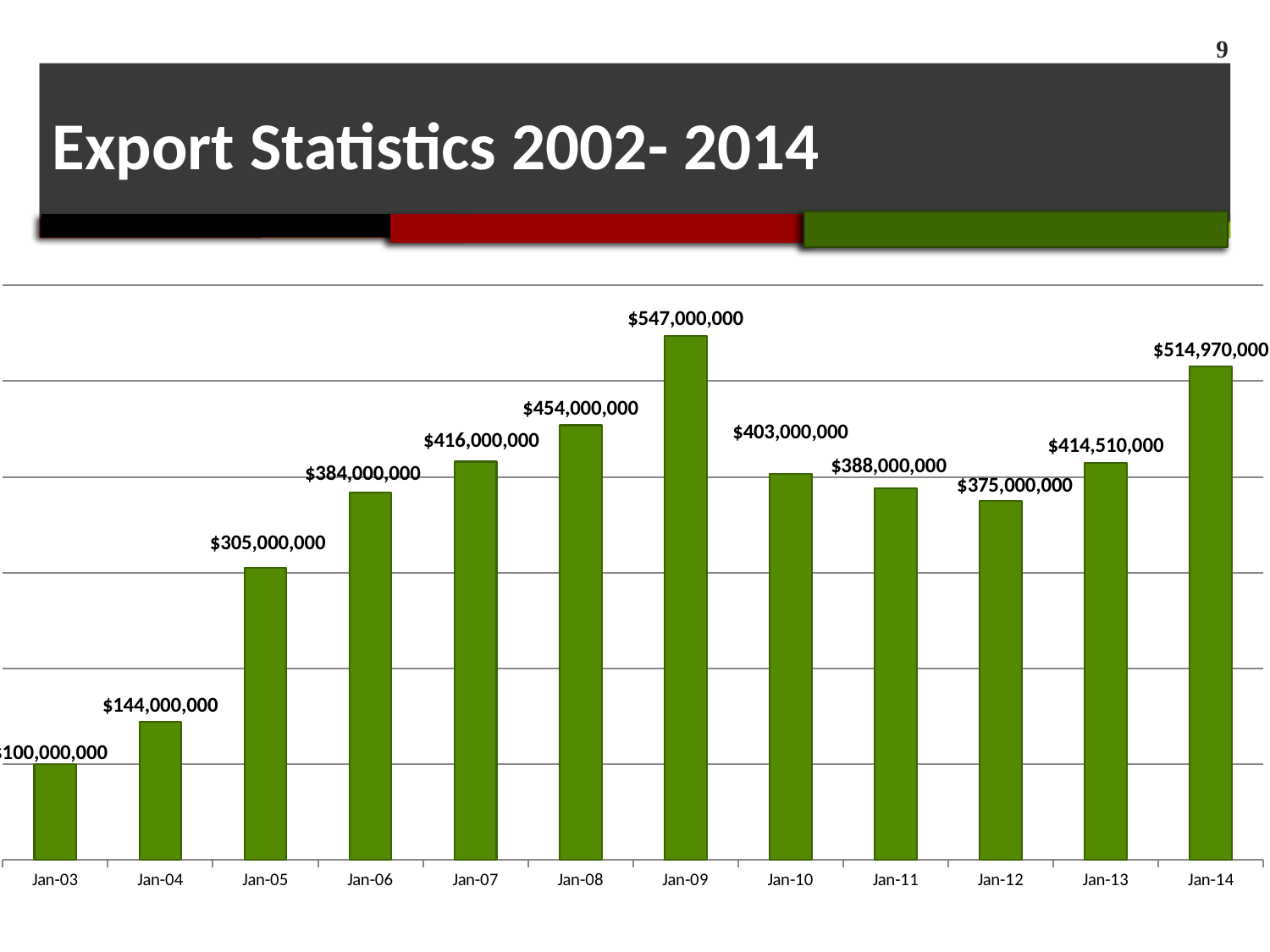
What is the value for Jan-14? $514,970,000 Which is larger, the value for Jan-08 or the value for Jan-10? Jan-08 What is the value for Jan-09? $547,000,000 Which year has the highest value? Jan-09 Which year has the lowest value? Jan-03 Do the values rise or fall from Jan-03 to Jan-09? Rise What is the value for Jan-12? $375,000,000 What is the difference between the values for Jan-05 and Jan-04? $161,000,000 How many bars are shown in the chart? 12 What kind of chart is shown on the slide? Bar chart What is the value for Jan-13? $414,510,000 What is the difference between the values for Jan-09 and Jan-14? $32,030,000